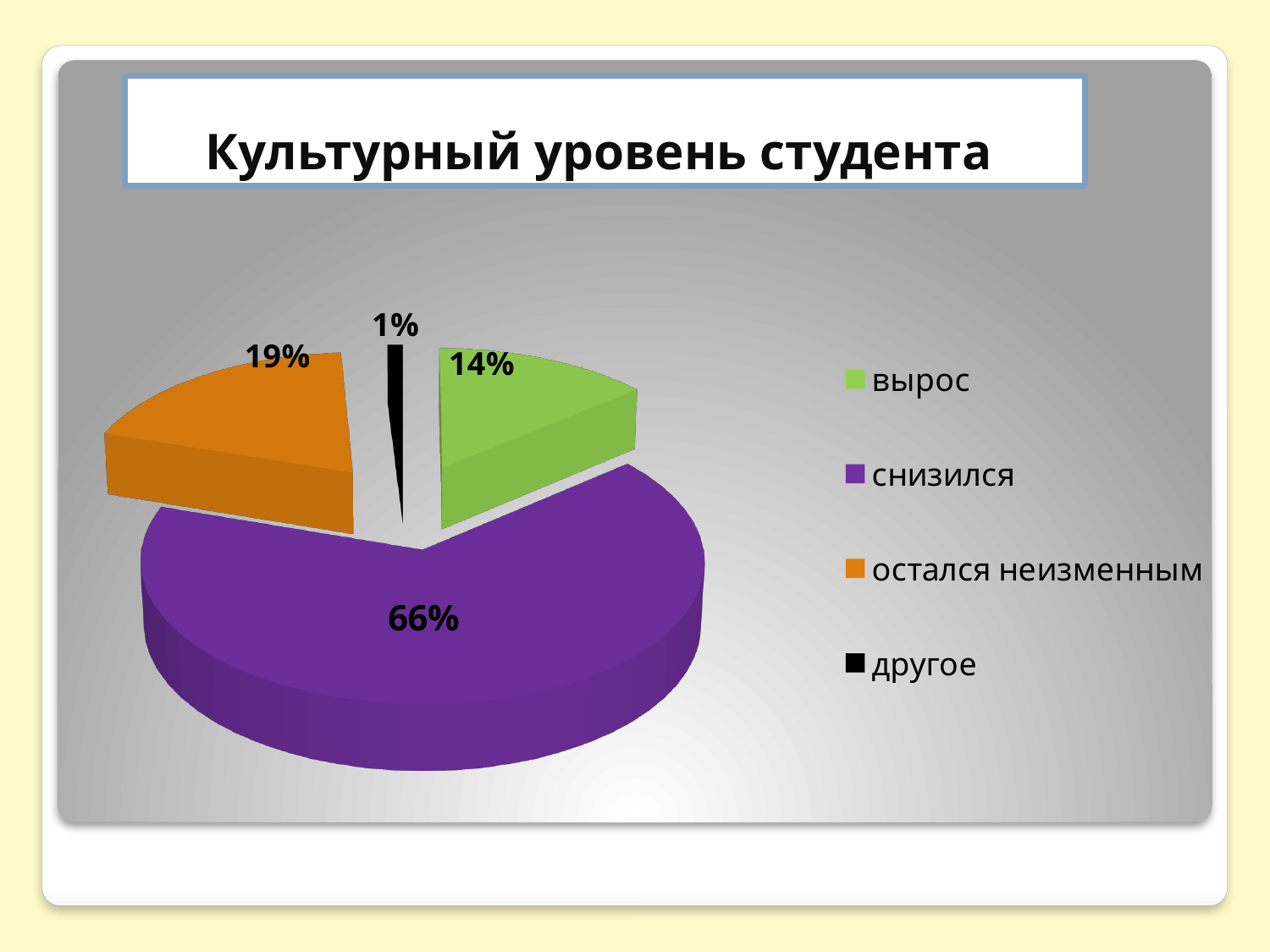
What is the value shown for "вырос"? 14% What is the difference between the values for "остался неизменным" and "вырос"? 5% What is the title of the chart? Культурный уровень студента What kind of chart is shown on the slide? pie chart What is the difference between the values for "снизился" and "остался неизменным"? 47% Which category has the smallest slice of the pie? другое How many categories does the pie chart show? 4 Which is larger, the value for "вырос" or the value for "остался неизменным"? остался неизменным What is the value shown for "остался неизменным"? 19% Which category has the largest slice of the pie? снизился What share of the pie does the "снизился" slice represent? 66% What is the value shown for "другое"? 1%